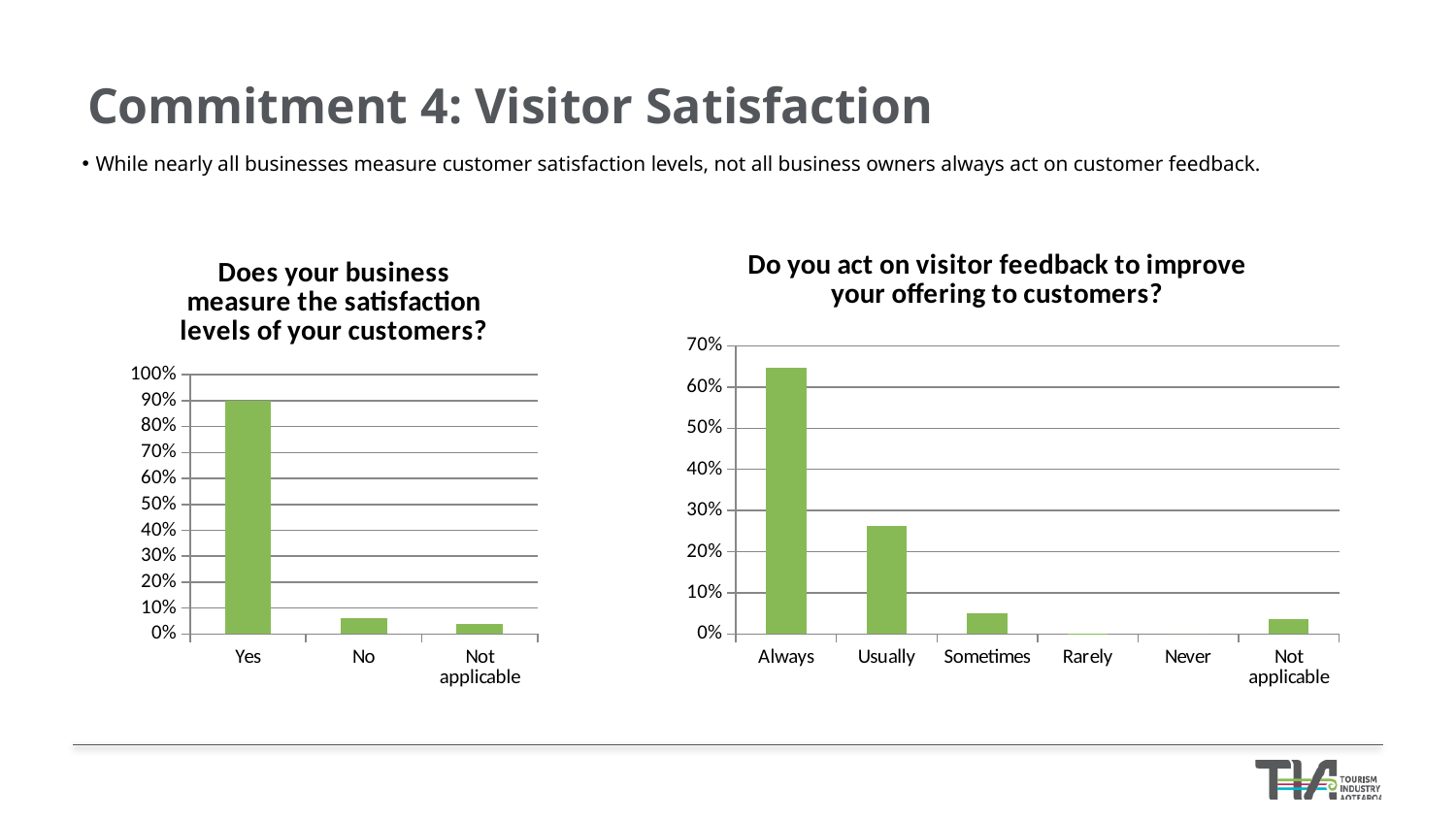
In the right chart, 'Do you act on visitor feedback to improve your offering to customers?', which is larger, the value for Always or the value for Usually? Always In the left chart, 'Does your business measure the satisfaction levels of your customers?', which category has the highest value? Yes How many categories are shown on the x axis of the left chart, 'Does your business measure the satisfaction levels of your customers?'? 3 In the right chart, 'Do you act on visitor feedback to improve your offering to customers?', is the value for Always greater or less than 60%? greater In the left chart, 'Does your business measure the satisfaction levels of your customers?', is the value for Yes greater or less than 80%? greater What kind of chart is the left chart, 'Does your business measure the satisfaction levels of your customers?'? bar chart In the right chart, 'Do you act on visitor feedback to improve your offering to customers?', which category has the highest value? Always What is the highest value shown on the y axis of the right chart, 'Do you act on visitor feedback to improve your offering to customers?'? 70% In the left chart, 'Does your business measure the satisfaction levels of your customers?', is the value for No greater or less than 10%? less How many categories are shown on the x axis of the right chart, 'Do you act on visitor feedback to improve your offering to customers?'? 6